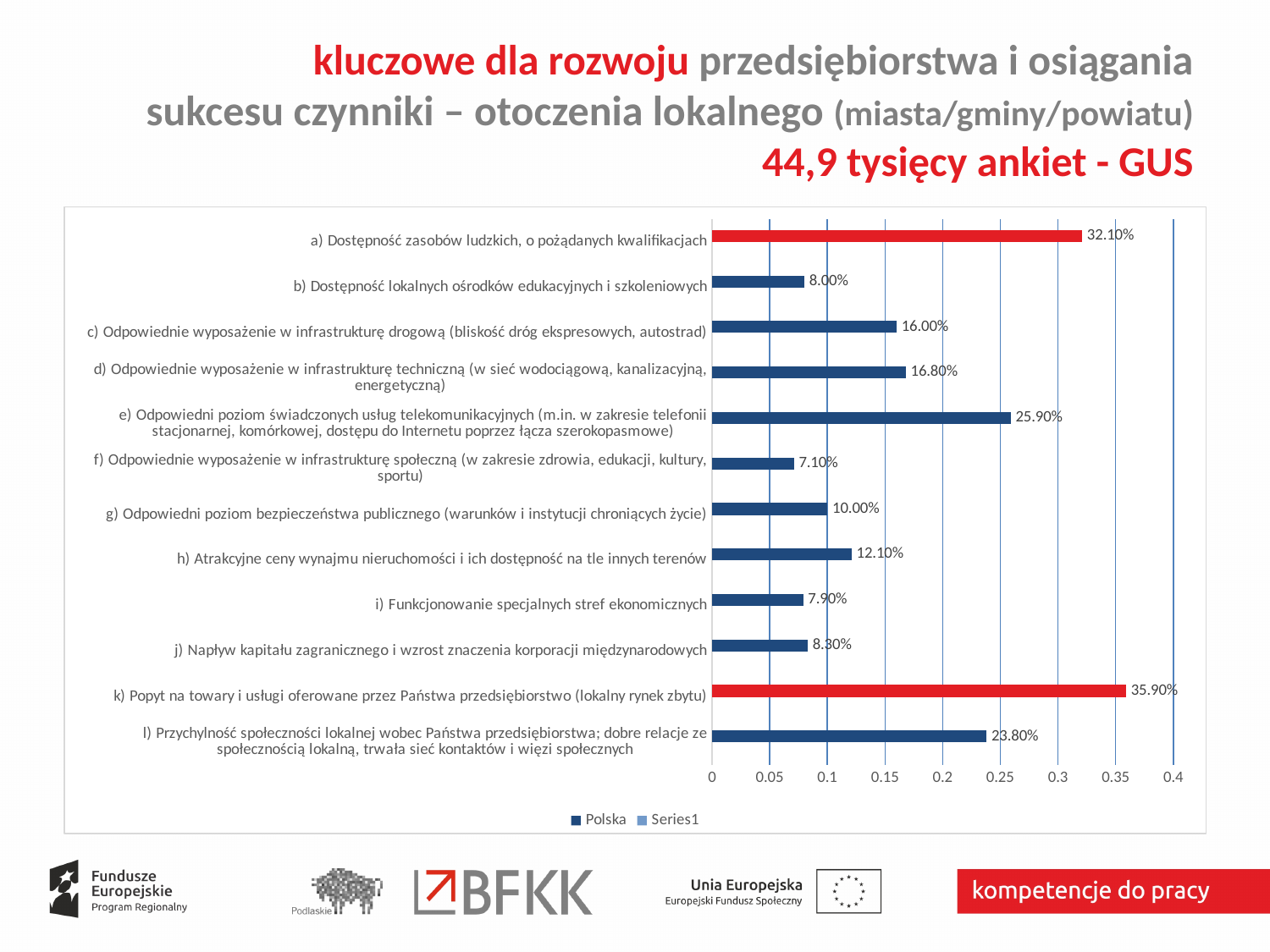
How many categories are shown in the chart? 12 What is the value for category h) Atrakcyjne ceny wynajmu nieruchomości i ich dostępność na tle innych terenów? 12.10% What is the difference between the values for category d) and category c)? 0.80% What is the value for category k) Popyt na towary i usługi oferowane przez Państwa przedsiębiorstwo (lokalny rynek zbytu)? 35.90% What is the value for category a) Dostępność zasobów ludzkich, o pożądanych kwalifikacjach? 32.10% How many series does the legend list? 2 What kind of chart is shown on the slide? Bar chart What is the value for category e) Odpowiedni poziom świadczonych usług telekomunikacyjnych? 25.90% Which has a larger value: category l) Przychylność społeczności lokalnej or category e) Odpowiedni poziom świadczonych usług telekomunikacyjnych? e) Odpowiedni poziom świadczonych usług telekomunikacyjnych Which category has the highest value? k) Popyt na towary i usługi oferowane przez Państwa przedsiębiorstwo (lokalny rynek zbytu) What is the difference between the values for category k) and category a)? 3.80% Which category has the lowest value? f) Odpowiednie wyposażenie w infrastrukturę społeczną (w zakresie zdrowia, edukacji, kultury, sportu)